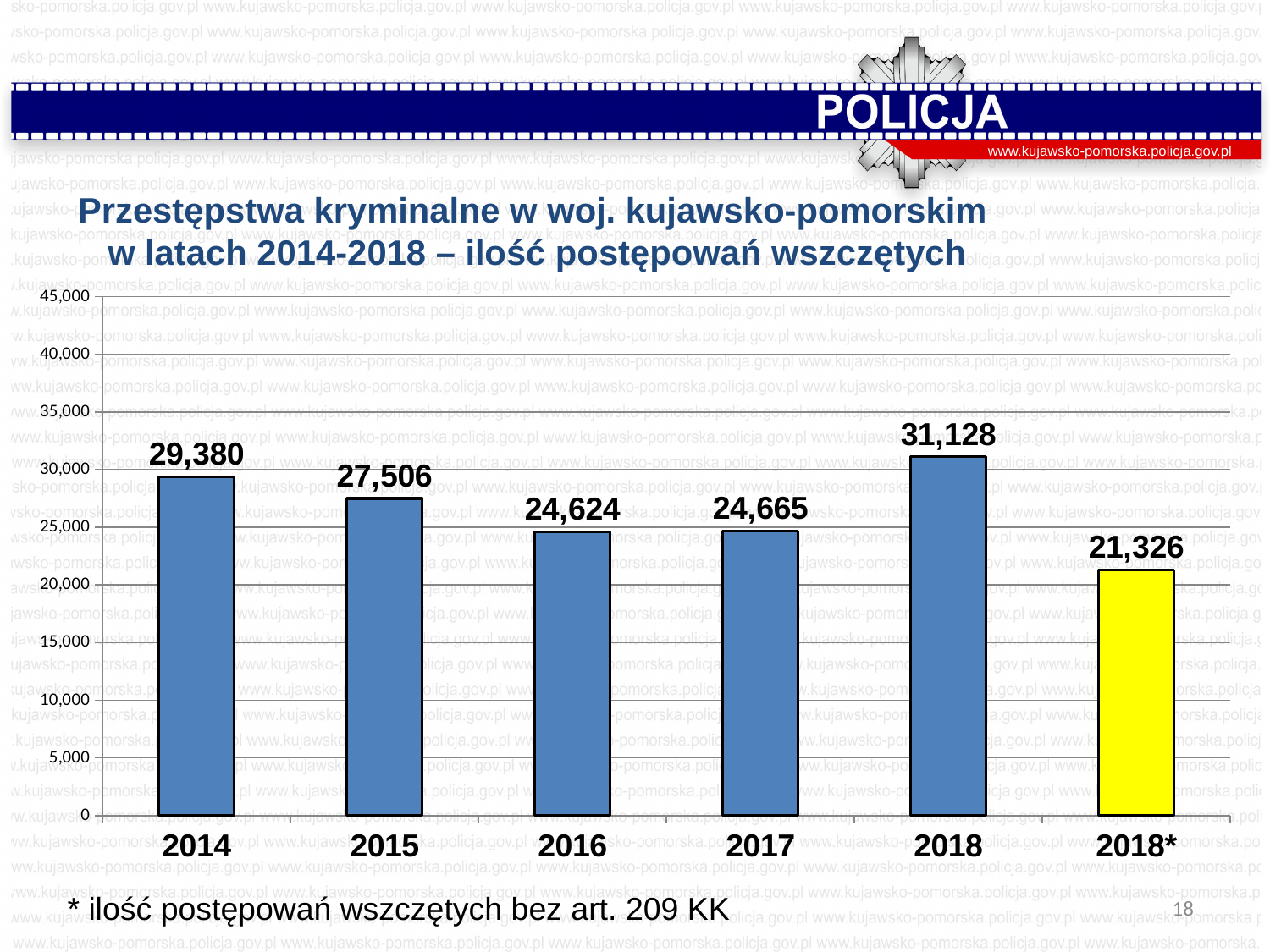
What is the value shown for 2014? 29,380 What is the value shown for 2016? 24,624 Is the value for 2018 greater or less than 30,000? greater What kind of chart is shown on the slide? bar chart Which is larger, the value for 2015 or the value for 2017? 2015 What is the difference between the values for 2018 and 2018*? 9,802 What is the difference between the values for 2014 and 2015? 1,874 How many bars are shown in the chart? 6 What is the value shown for 2018*? 21,326 Which category has the highest value? 2018 Which category has the lowest value? 2018* Which bar is coloured yellow instead of blue? 2018*